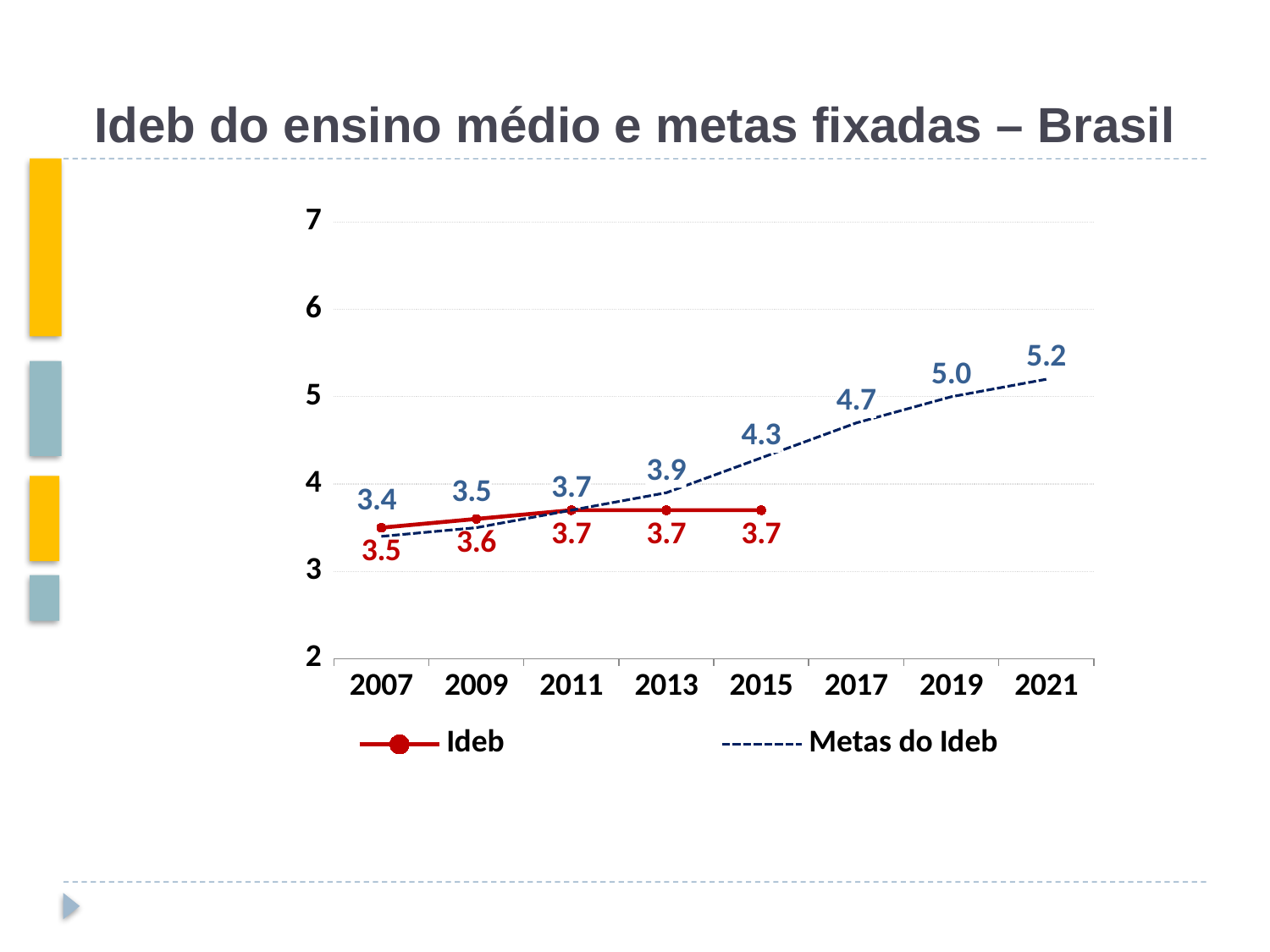
Do the Metas do Ideb values rise or fall from 2007 to 2021? Rise What is the difference between the Metas do Ideb value for 2021 and the Metas do Ideb value for 2007? 1.8 What is the Metas do Ideb value for 2013? 3.9 What kind of chart is shown on the slide? Line chart What is the Metas do Ideb value for 2021? 5.2 What is the Ideb value for 2007? 3.5 What is the Ideb value for 2015? 3.7 How many series does the legend list? 2 In which year is the Metas do Ideb value highest? 2021 Which is larger in 2015: the Ideb value or the Metas do Ideb value? Metas do Ideb In which year is the Ideb value lowest? 2007 What is the title of the chart? Ideb do ensino médio e metas fixadas – Brasil